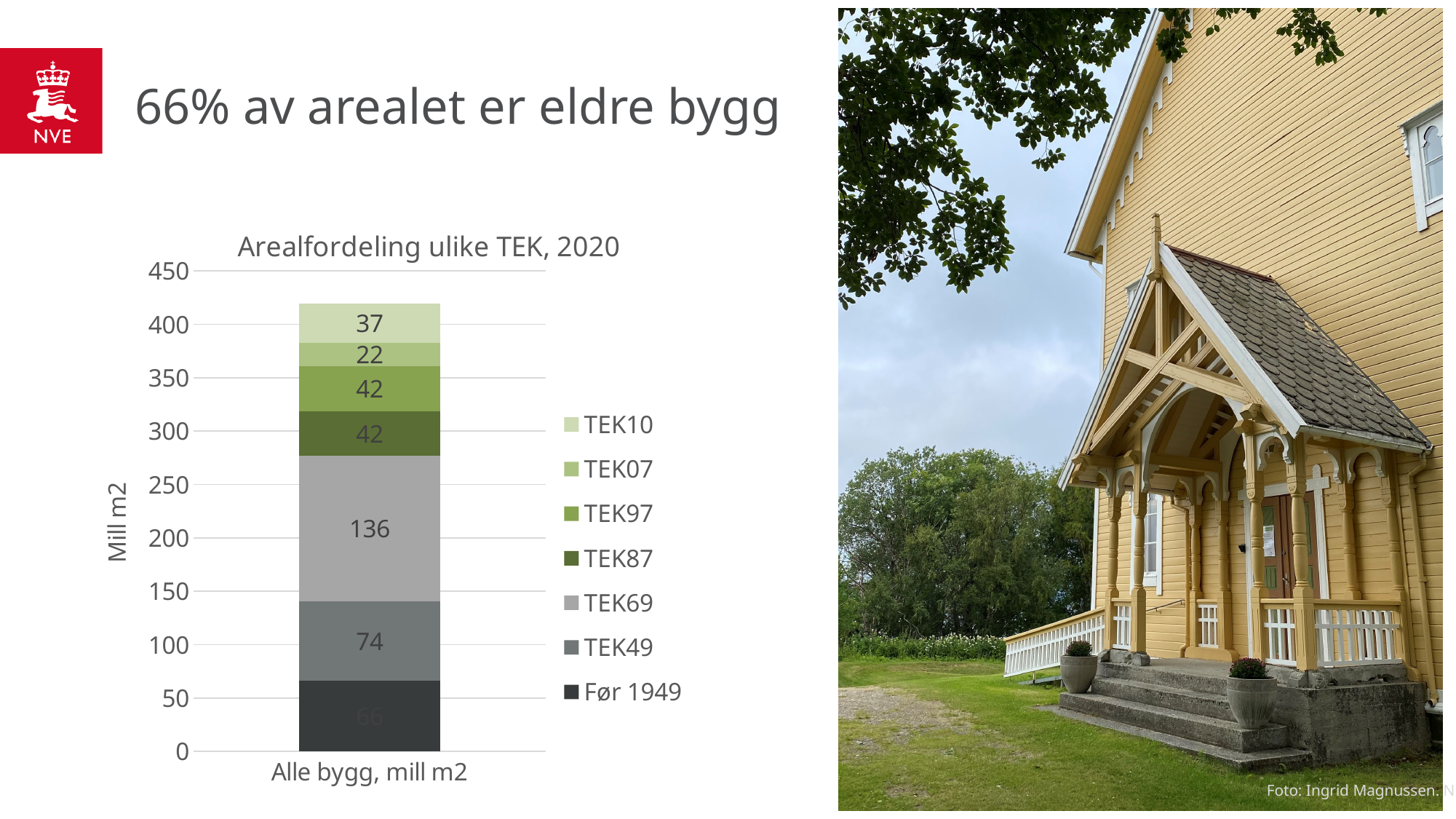
What is the title of the chart? Arealfordeling ulike TEK, 2020 How many series does the legend list? 7 What is the value for TEK69 in the stacked bar? 136 What is the difference between the TEK69 value and the TEK49 value? 62 What is the total of the stacked bar for Alle bygg, mill m2? 419 Which series has the smallest segment in the stacked bar? TEK07 Which is larger, the value for TEK10 or the value for TEK07? TEK10 What kind of chart is shown on the slide? Stacked bar chart What is the value for TEK07 in the stacked bar? 22 What is the value for TEK10 in the stacked bar? 37 Which series has the largest segment in the stacked bar? TEK69 What is the value for TEK49 in the stacked bar? 74